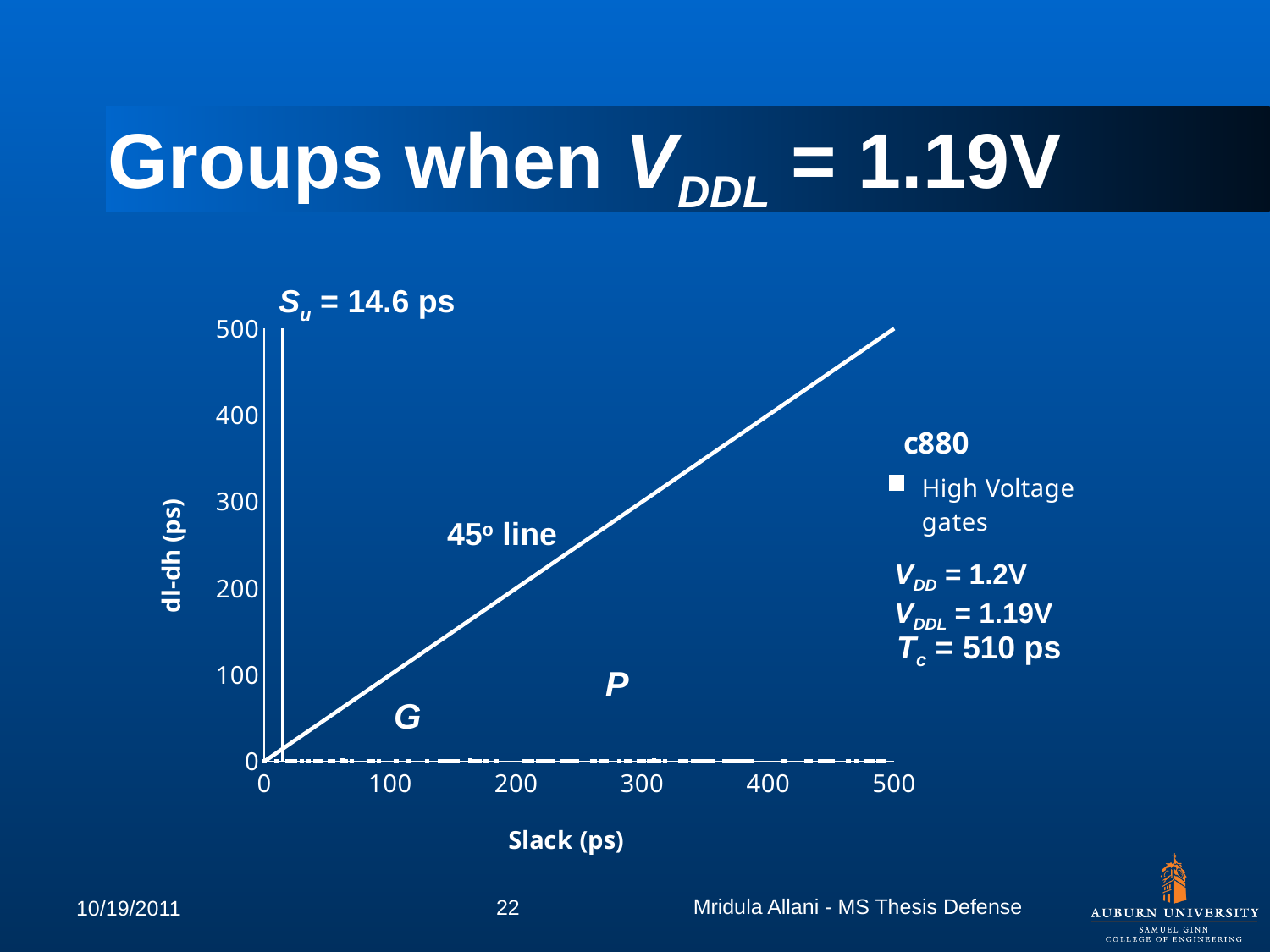
Do the dl-dh values of the High Voltage gates points rise, fall, or stay flat as Slack increases? stay flat How many data series does the chart legend list? 1 What is the highest tick value shown on the x axis? 500 What is the label of the x axis? Slack (ps) What is the label of the y axis? dl-dh (ps) What value of Su is annotated on the chart? 14.6 ps Are the dl-dh values of the High Voltage gates points greater or less than 100? less What value of Tc is annotated on the chart? 510 ps What is the title shown above the chart legend? c880 What kind of chart is shown on the slide? scatter chart What is the highest tick value shown on the y axis? 500 What is the name of the series listed in the chart legend? High Voltage gates